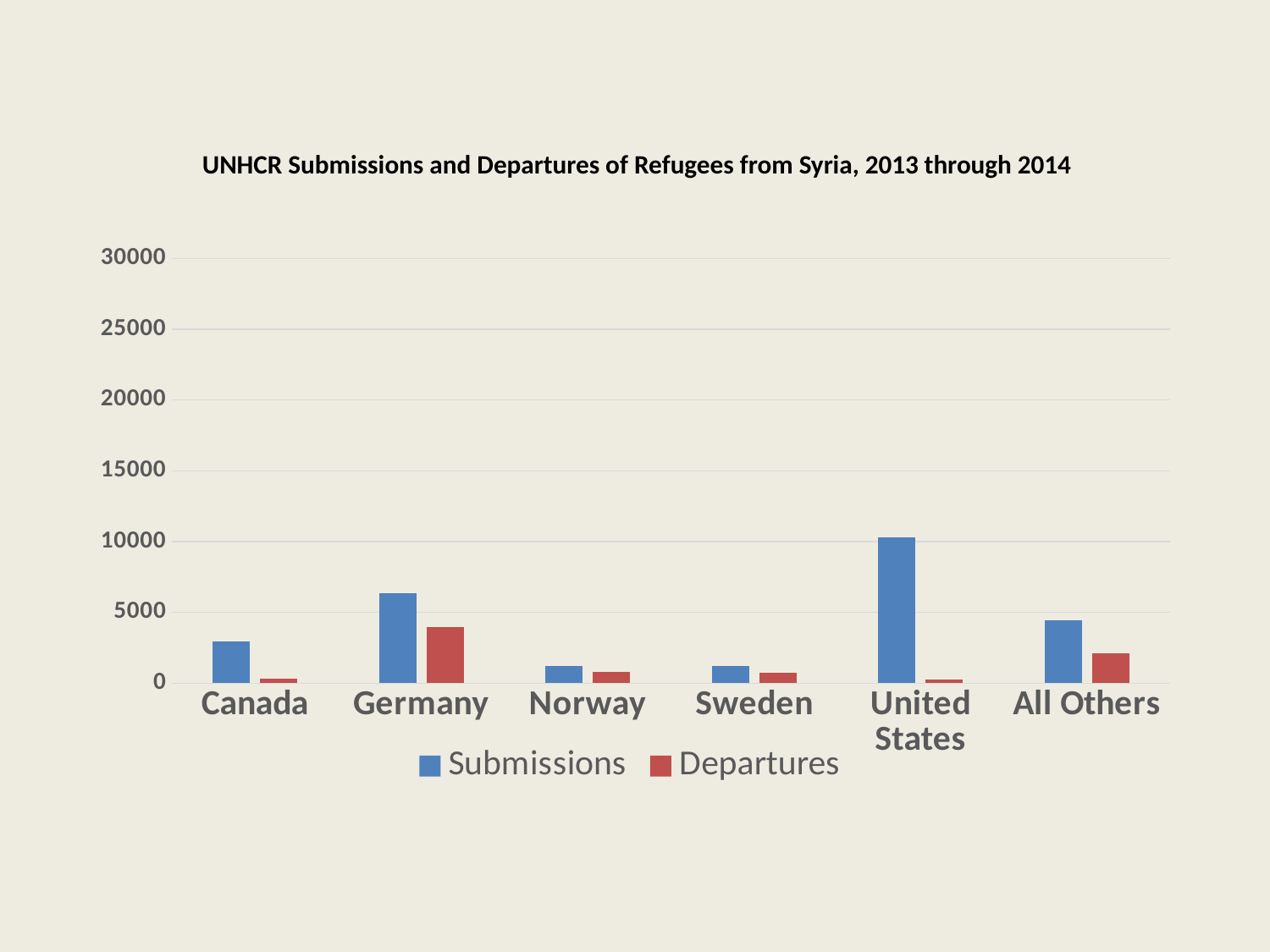
Is the Departures value for Germany greater or less than 5000? less How many categories are shown on the x axis? 6 Which is larger, the Submissions value for Germany or the Submissions value for All Others? Germany What is the title of the chart? UNHCR Submissions and Departures of Refugees from Syria, 2013 through 2014 Which category has the highest Departures value? Germany How many series does the legend list? 2 What kind of chart is shown on the slide? bar chart Which is larger for Canada, Submissions or Departures? Submissions Is the Submissions value for Canada greater or less than 5000? less Is the Submissions value for Germany greater or less than 5000? greater Which category has the highest Submissions value? United States